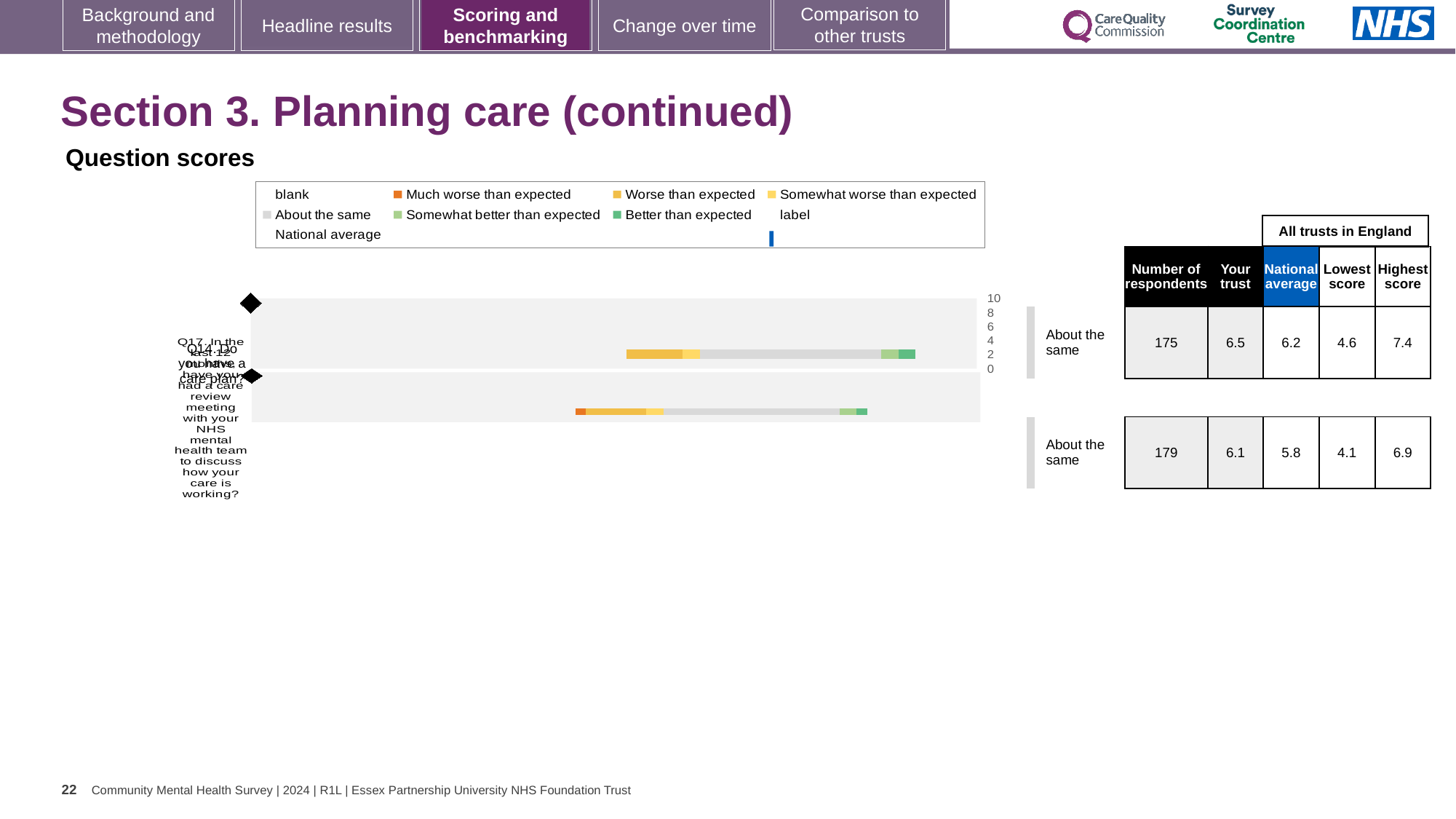
For Q14, which is larger: the 'Your trust' score or the national average? Your trust In the table beside the chart, what is the number of respondents for Q14? 175 What benchmark category is shown next to the chart for both Q14 and Q17? About the same What colour does the legend use for 'Much worse than expected'? orange In the table beside the chart, what is the lowest score across all trusts in England for Q17? 4.1 In the table beside the chart, what is the national average for Q14? 6.2 What is the difference between the 'Your trust' score and the national average for Q14? 0.3 What type of chart is shown under 'Question scores'? bar chart Which question has the higher 'Your trust' score, Q14 or Q17? Q14 What is the difference between the highest score and the lowest score for Q17? 2.8 How many questions (bars) are plotted in the Question scores chart? 2 In the table beside the chart, what is the 'Your trust' score for Q17? 6.1